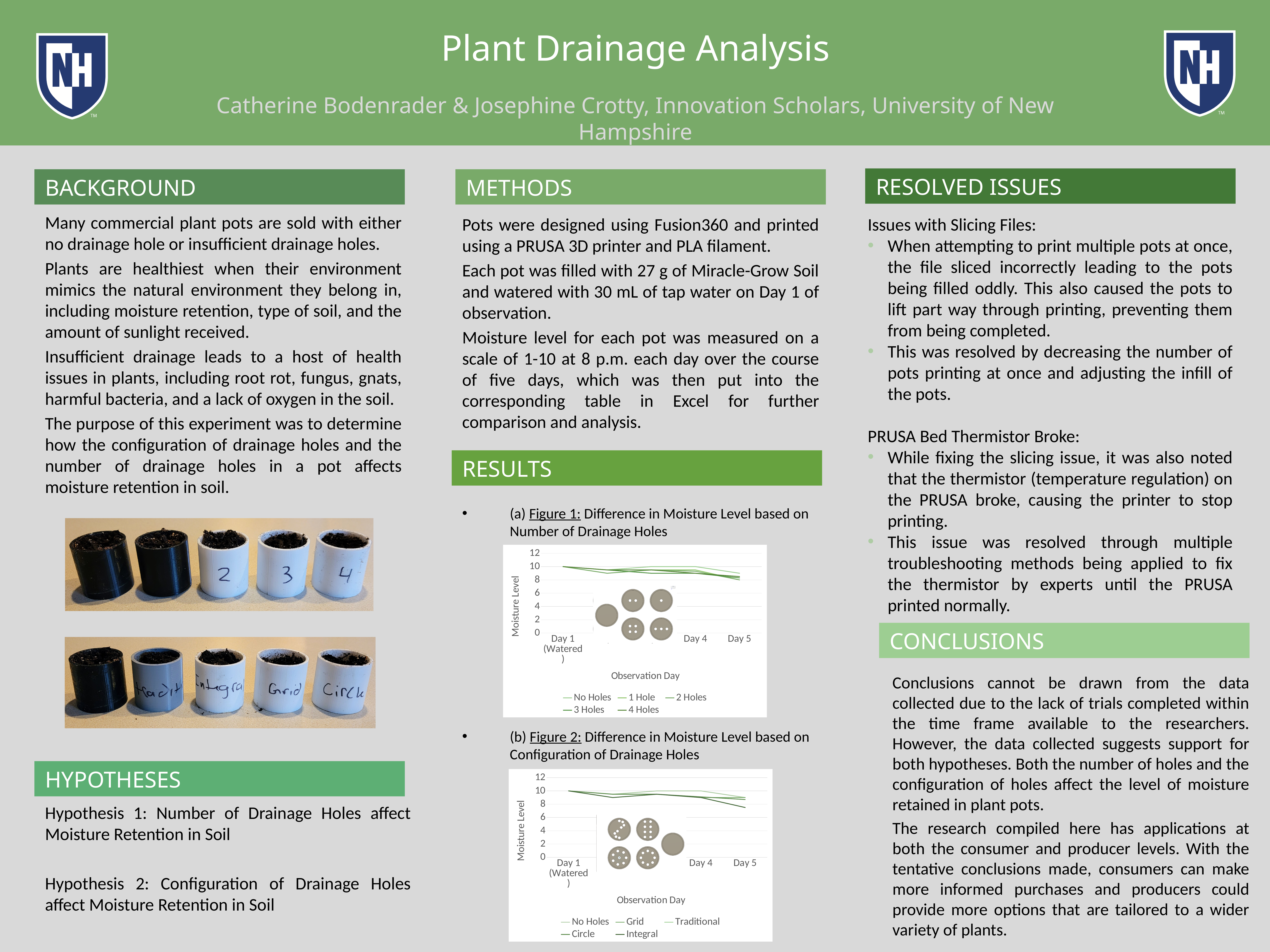
In Figure 1, do the moisture level values rise or fall from Day 1 to Day 5? fall What kind of chart is Figure 2 (Difference in Moisture Level based on Configuration of Drainage Holes)? line chart What is the y-axis label of Figure 2? Moisture Level How many series does the legend of Figure 2 list? 5 How many series does the legend of Figure 1 list? 5 In Figure 1, is the moisture level for every series on Day 1 (Watered) greater or less than 8? greater What kind of chart is Figure 1 (Difference in Moisture Level based on Number of Drainage Holes)? line chart In Figure 1, is the moisture level for every series on Day 5 greater or less than 10? less In Figure 2, do the moisture level values rise or fall from Day 1 to Day 5? fall In Figure 2, is the moisture level for every series on Day 5 greater or less than 6? greater What are the legend entries of Figure 2? No Holes, Grid, Traditional, Circle, Integral